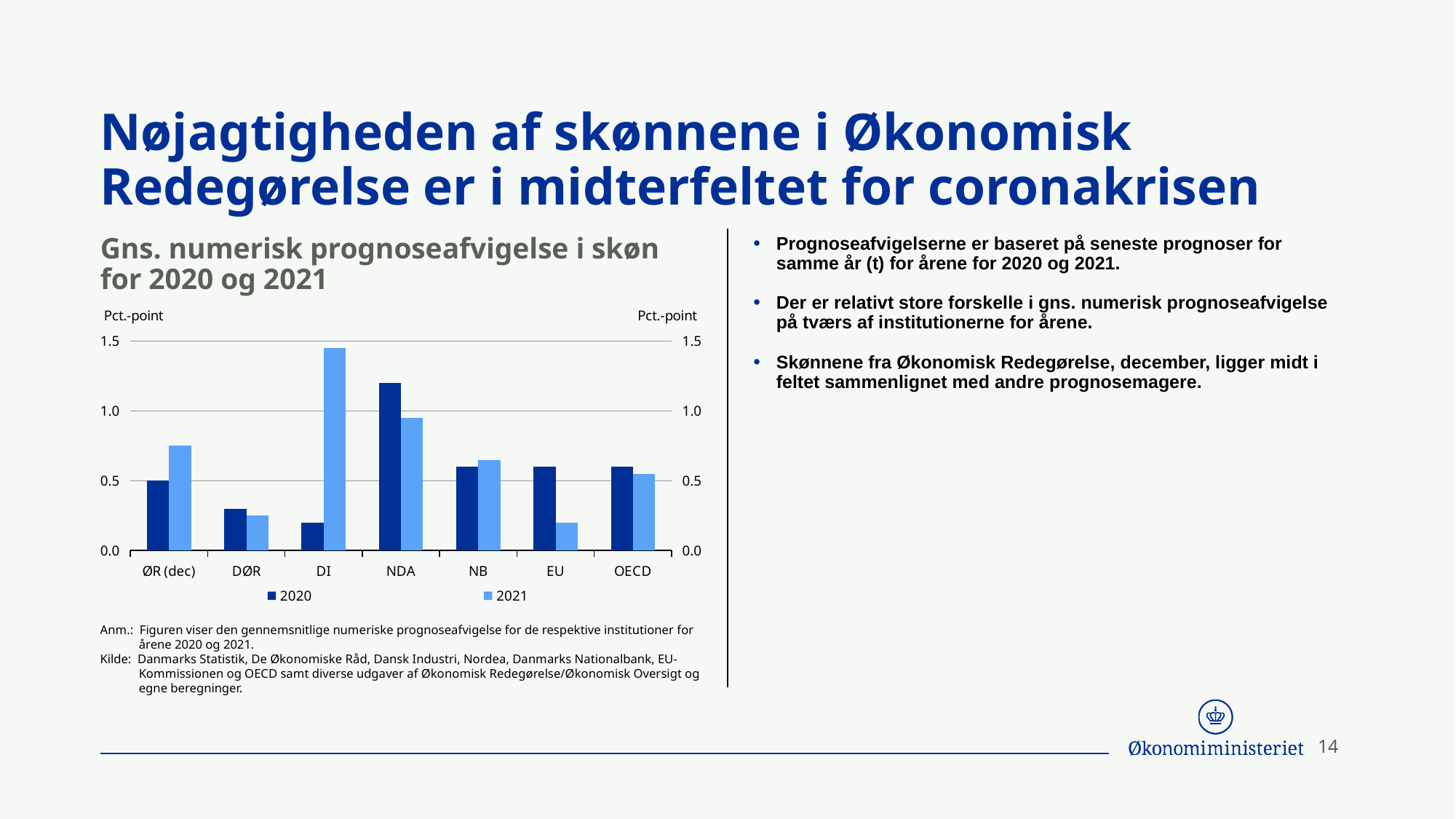
Is the 2020 value for NDA greater or less than 1.0? greater For DI, which series has the larger value, 2020 or 2021? 2021 Which institution has the lowest value for 2021? EU Which institution has the highest value for 2020? NDA How many series does the chart legend list? 2 How many institutions (categories) are shown on the x axis of the chart? 7 Which institution has the highest value for 2021? DI Which institution has the lowest value for 2020? DI Is the 2021 value for EU greater or less than 0.5? less What kind of chart is shown on the slide? bar chart Is the 2021 value for DI greater or less than 1.0? greater What unit is shown on the vertical axis of the chart? Pct.-point